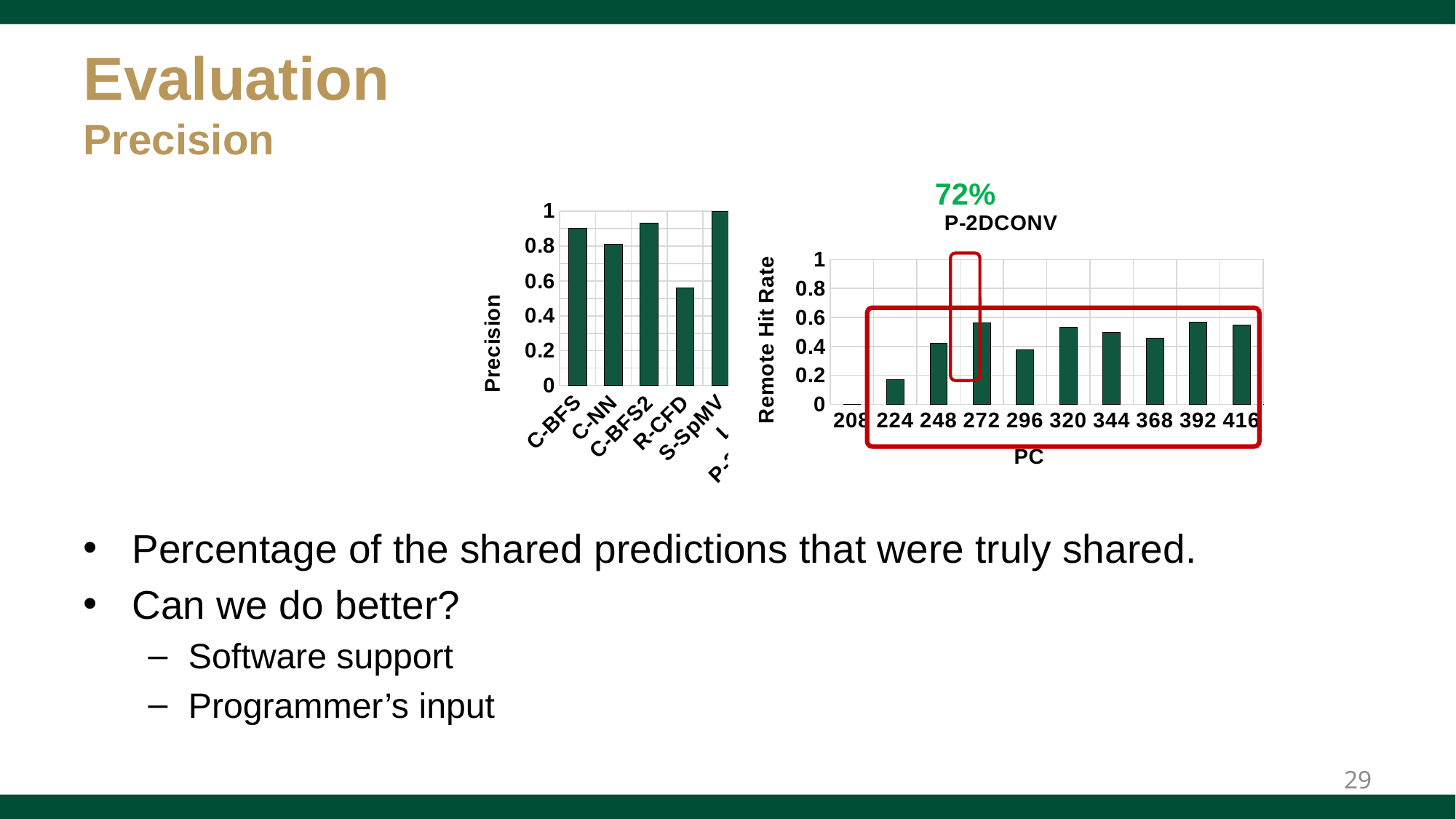
In the left chart (Precision), which category has the lowest precision? R-CFD In the left chart (Precision), is the value for R-CFD greater or less than 0.6? less In the right chart (P-2DCONV), how many PC values are shown on the x axis? 10 In the left chart (Precision), which category has the highest precision? S-SpMV In the right chart (P-2DCONV), what is the label of the y axis? Remote Hit Rate In the left chart (Precision), what kind of chart is shown? bar chart In the right chart (P-2DCONV), is the value for PC 224 greater or less than 0.2? less In the right chart (P-2DCONV), which PC has the lowest remote hit rate? 208 In the left chart (Precision), is the value for C-BFS greater or less than 0.8? greater In the left chart (Precision), which is larger, the precision for C-BFS or for R-CFD? C-BFS In the right chart (P-2DCONV), which is larger, the remote hit rate for PC 224 or for PC 248? 248